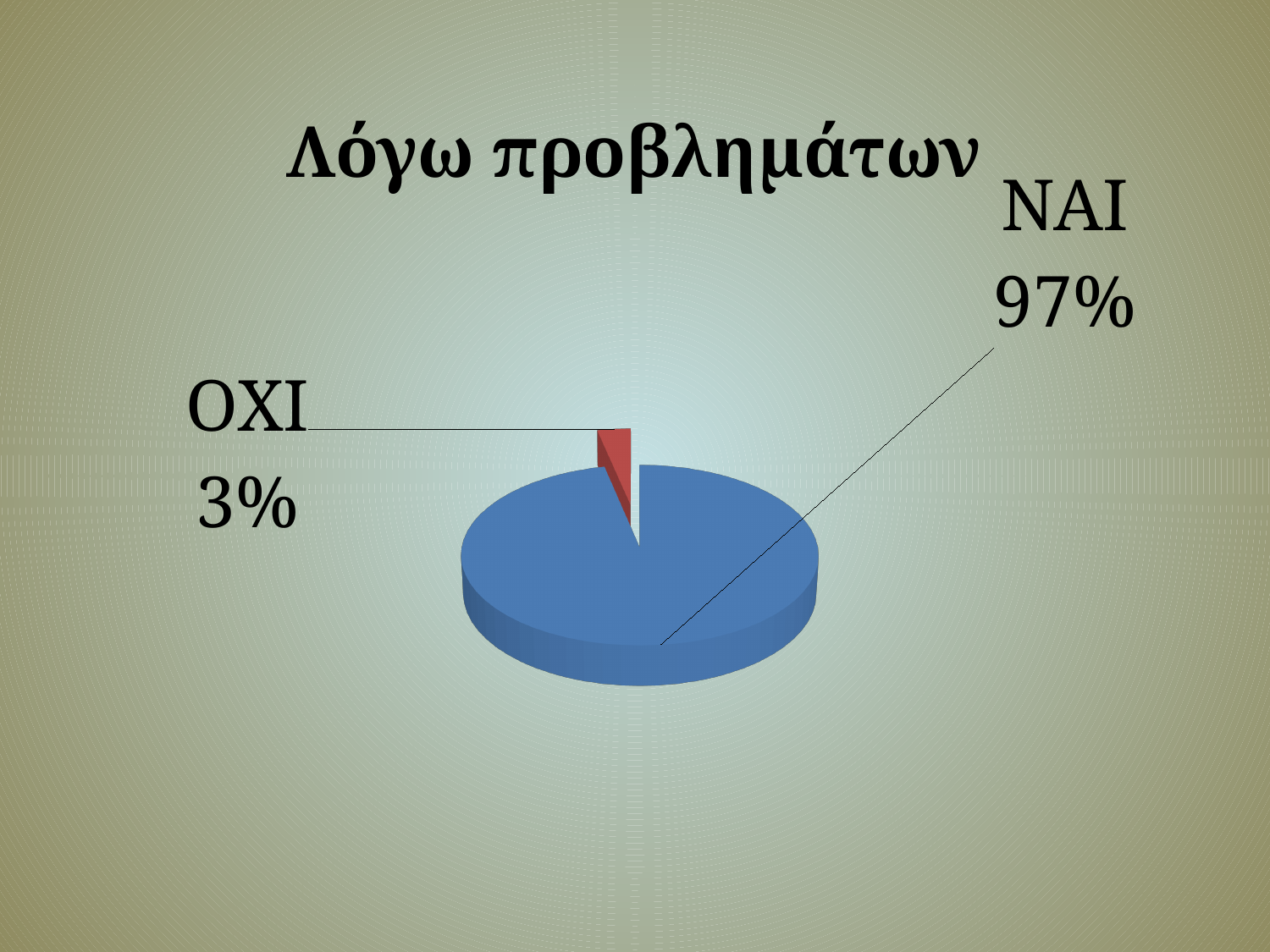
What share of the pie does ΟΧΙ represent? 3% Which is larger, ΝΑΙ or ΟΧΙ? ΝΑΙ What kind of chart is shown on the slide? pie chart What share of the pie does ΝΑΙ represent? 97% Which slice is the smallest? ΟΧΙ How many slices does the pie chart have? 2 What colour is the ΟΧΙ slice? red What is the title of the chart? Λόγω προβλημάτων What is the difference in percentage points between ΝΑΙ and ΟΧΙ? 94 Which slice is the largest? ΝΑΙ